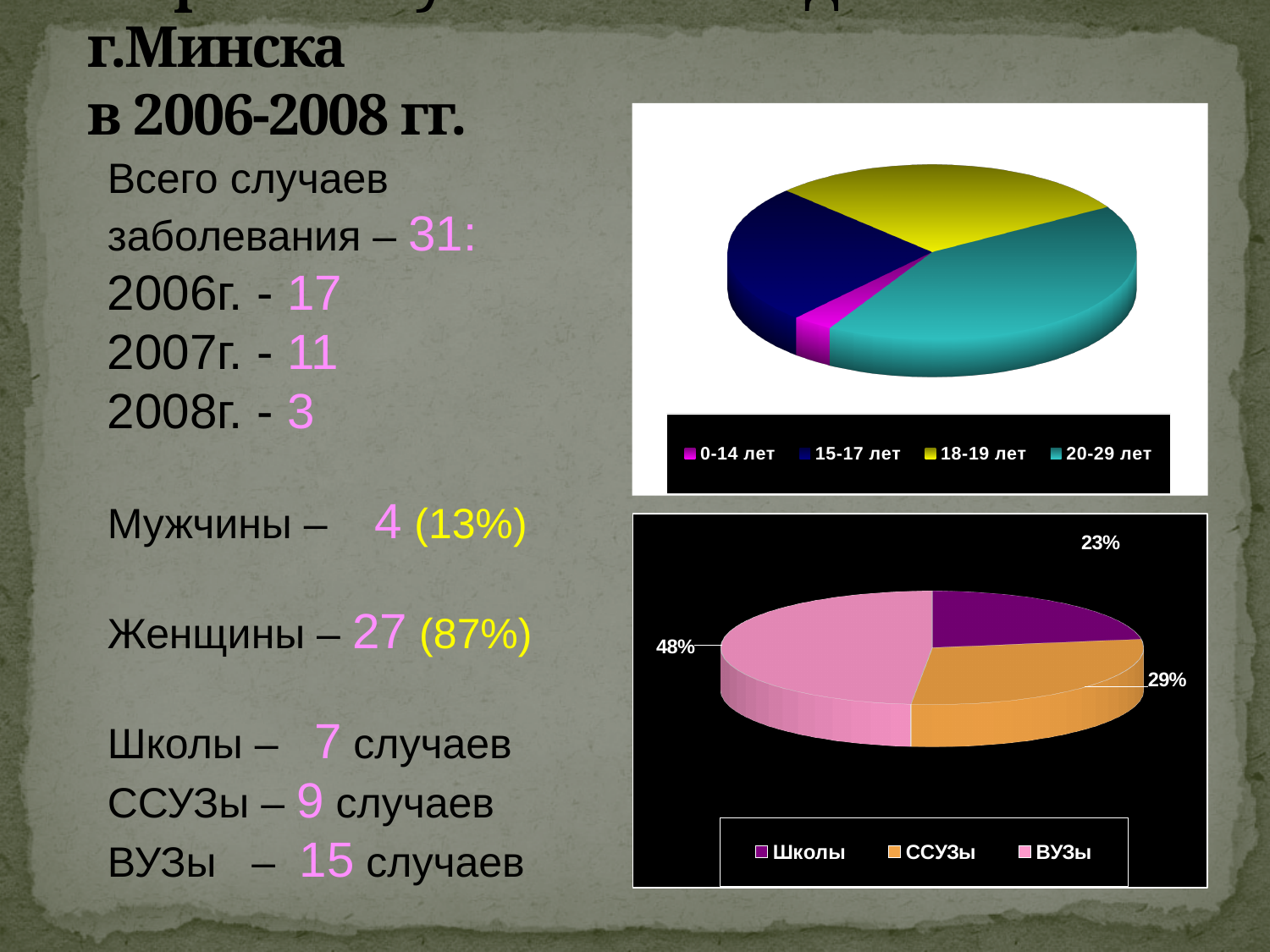
In the top chart, which age group has the largest slice? 20-29 лет In the bottom chart, what is the difference between the shares of ВУЗы and ССУЗы? 19% In the bottom chart, what share is shown for ВУЗы? 48% In the top chart, which colour represents the 18-19 лет group? yellow In the bottom chart, what share is shown for Школы? 23% What kind of chart is the top chart on the slide? pie chart In the bottom chart, which category has the largest share? ВУЗы In the bottom chart, what share is shown for ССУЗы? 29% What kind of chart is the bottom chart on the slide? pie chart In the top chart, how many age groups does the legend list? 4 In the top chart, which age group has the smallest slice? 0-14 лет In the bottom chart, which category has the smallest share? Школы